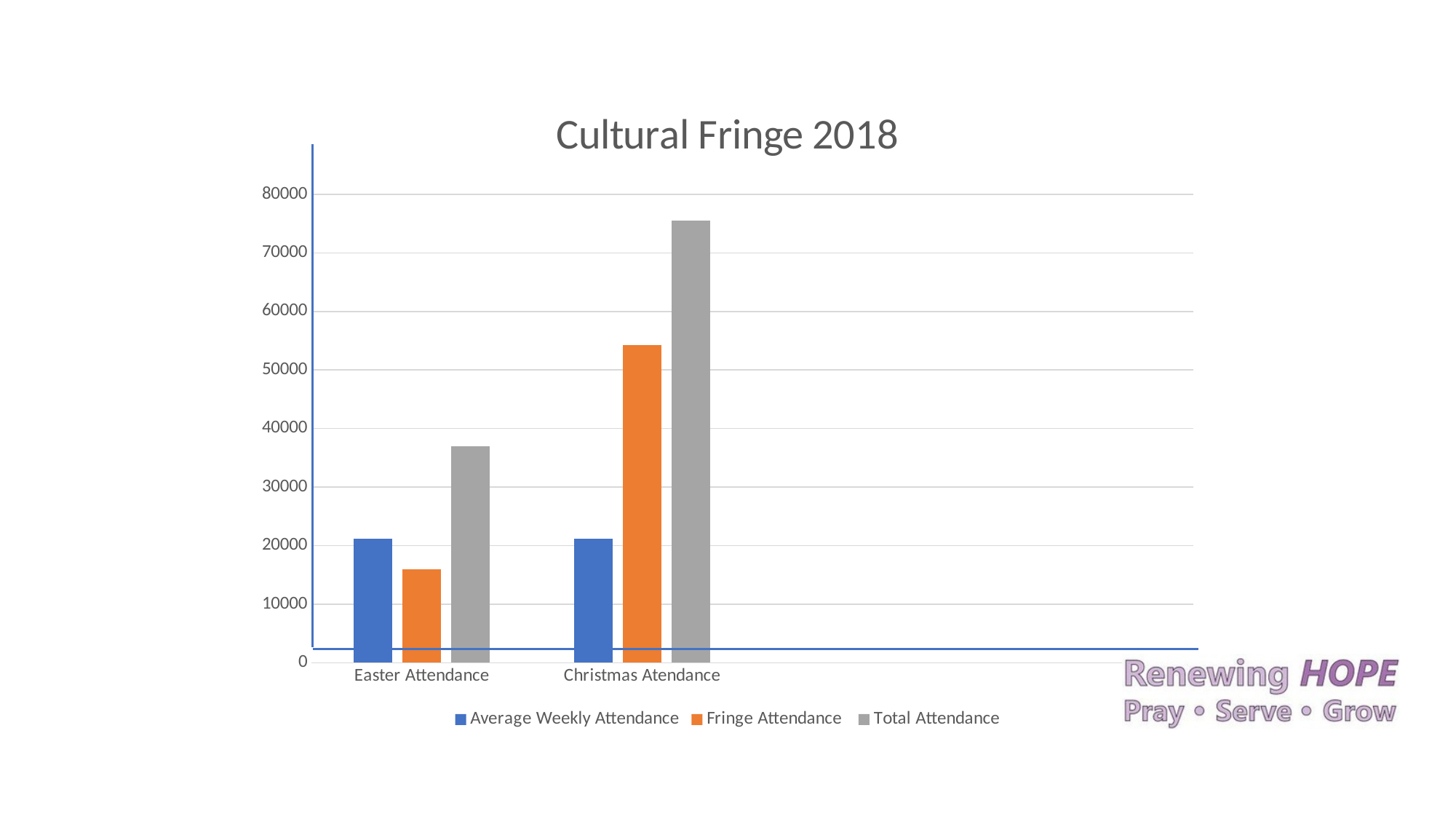
Which category has the higher Total Attendance? Christmas Atendance Is the Fringe Attendance value for Easter Attendance greater or less than 20000? less What kind of chart is shown on the slide? bar chart Is the Fringe Attendance value for Christmas Atendance greater or less than 50000? greater Which series is shown in orange in the legend? Fringe Attendance Is the Total Attendance value for Easter Attendance greater or less than 40000? less How many categories are shown on the x axis? 2 How many series does the legend list? 3 Which series has the lowest value for Easter Attendance? Fringe Attendance What is the title of the chart? Cultural Fringe 2018 Which series has the highest value for Christmas Atendance? Total Attendance